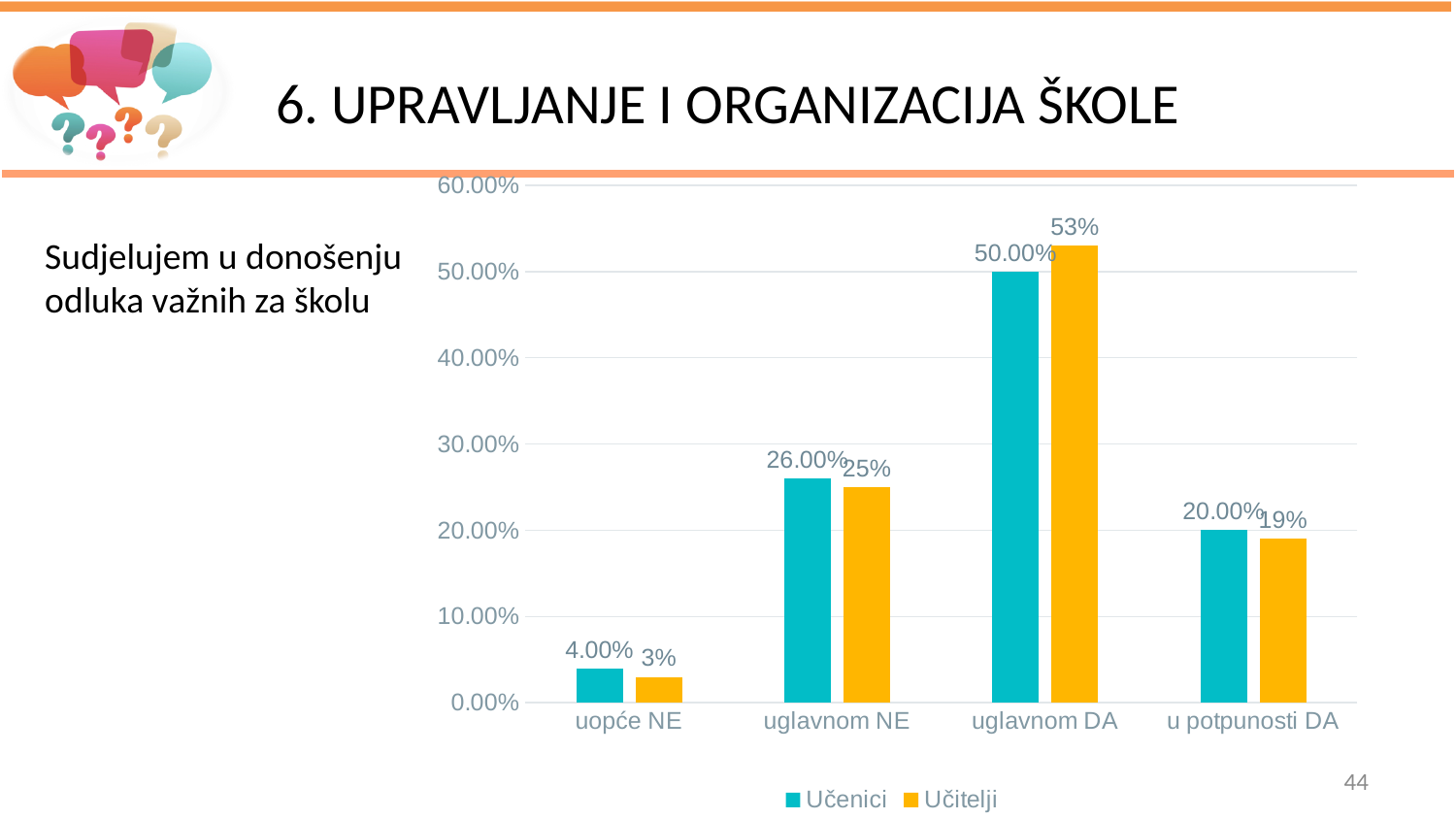
Which category has the lowest value for Učenici? uopće NE What is the value for Učitelji in the 'u potpunosti DA' category? 19% How many categories are shown on the x axis? 4 How many series does the legend list? 2 What is the value for Učenici in the 'uopće NE' category? 4.00% What is the value for Učenici in the 'uglavnom DA' category? 50.00% Which colour represents the Učitelji series? Orange/yellow Which category has the highest value for Učitelji? uglavnom DA What is the difference between the Učitelji and Učenici values in the 'uglavnom DA' category? 3 percentage points What is the value for Učitelji in the 'uglavnom NE' category? 25% In the 'uglavnom NE' category, which series has the larger value, Učenici or Učitelji? Učenici What kind of chart is shown on the slide? Bar chart